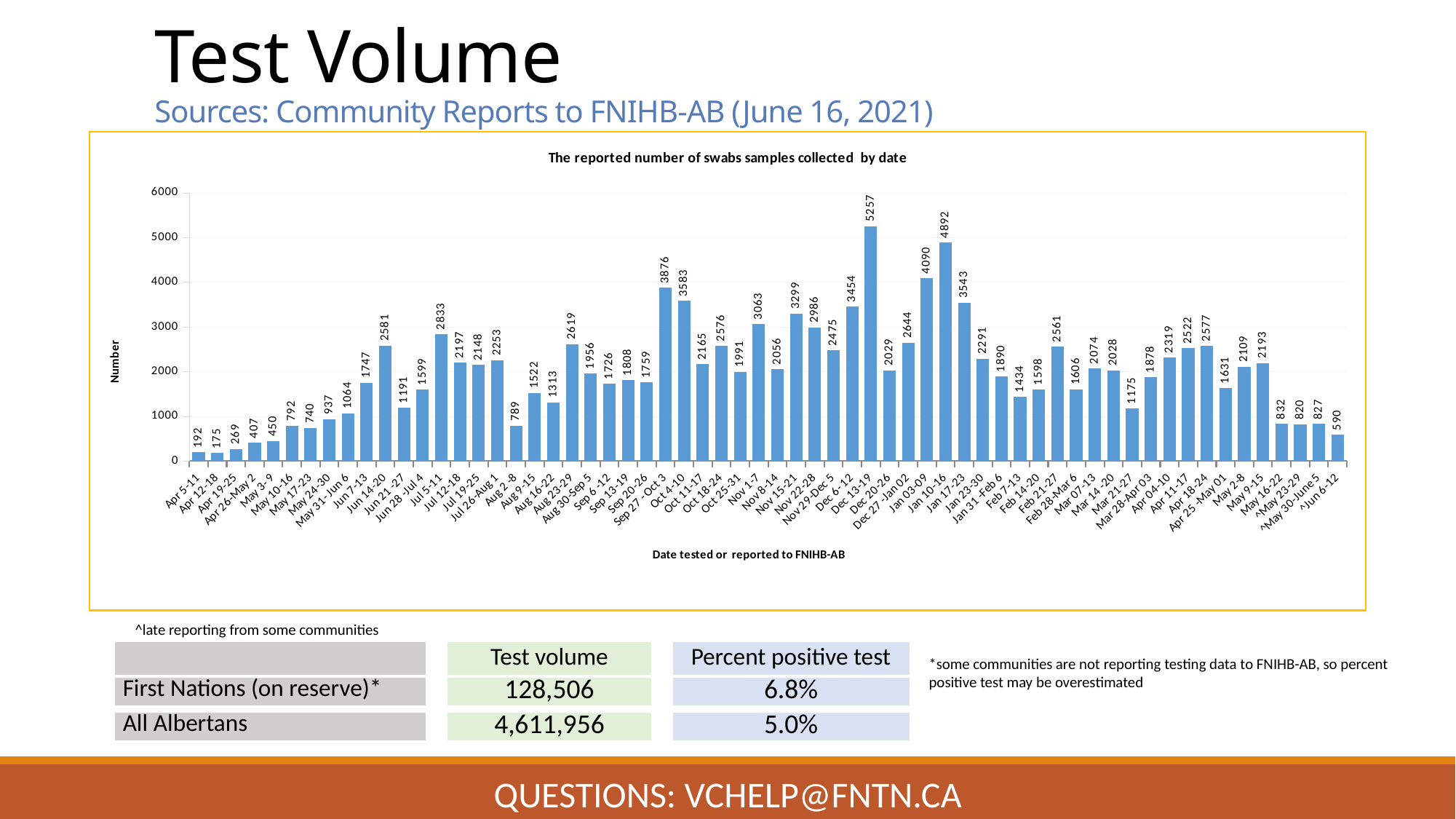
What is the label of the vertical axis? Number Do the values rise or fall from Apr 5-11 to May 31-Jun 6? Rise Which date period has the highest number of swab samples? Dec 13-19 What is the reported number of swab samples for Jun 6-12? 590 Which has more swab samples, Sep 27-Oct 3 or Oct 4-10? Sep 27-Oct 3 What is the reported number of swab samples for Jul 5-11? 2833 What is the difference between the number of swab samples for Jan 10-16 and Jan 03-09? 802 What is the title of the chart? The reported number of swabs samples collected by date Which date period has the lowest number of swab samples? Apr 12-18 What type of chart is shown on the slide? Bar chart What is the reported number of swab samples for Dec 13-19? 5257 Is the value for Nov 1-7 greater or less than 3000? greater